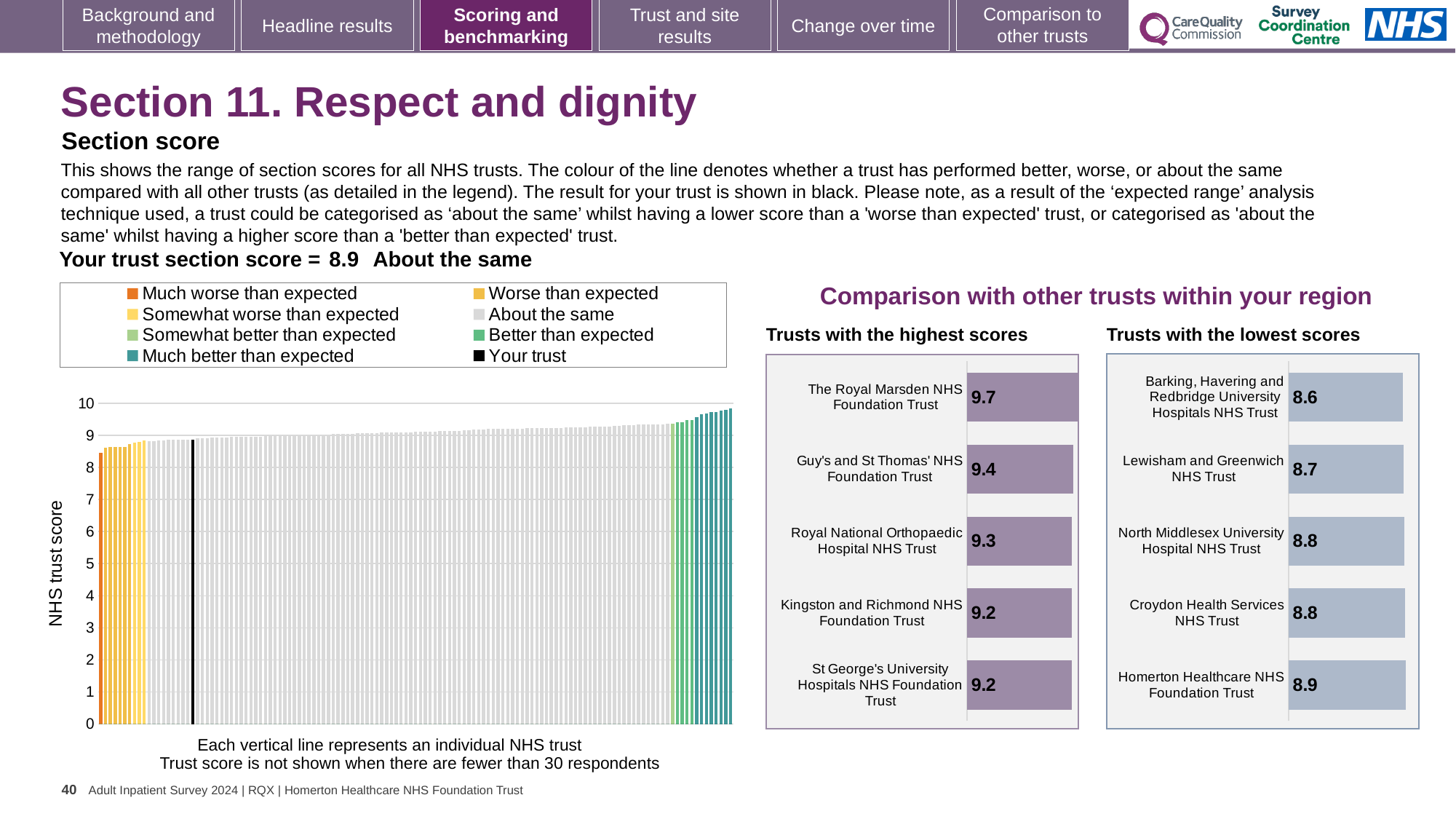
What kind of chart is the large 'NHS trust score' chart on the left of the slide? bar chart In the large 'NHS trust score' chart on the left, is the value for the black 'Your trust' bar greater or less than 5? greater In the 'Trusts with the highest scores' chart, which has the higher score: Royal National Orthopaedic Hospital NHS Trust or Kingston and Richmond NHS Foundation Trust? Royal National Orthopaedic Hospital NHS Trust In the 'Trusts with the highest scores' chart, which trust has the highest score? The Royal Marsden NHS Foundation Trust In the 'Trusts with the lowest scores' chart, which trust has the lowest score? Barking, Havering and Redbridge University Hospitals NHS Trust In the 'Trusts with the highest scores' chart, what is the difference between the scores of The Royal Marsden NHS Foundation Trust and Guy's and St Thomas' NHS Foundation Trust? 0.3 How many entries does the legend of the large 'NHS trust score' chart on the left list? 8 In the 'Trusts with the lowest scores' chart, what is the score for Lewisham and Greenwich NHS Trust? 8.7 In the 'Trusts with the lowest scores' chart, what is the difference between the scores of Homerton Healthcare NHS Foundation Trust and Barking, Havering and Redbridge University Hospitals NHS Trust? 0.3 In the 'Trusts with the highest scores' chart, what is the score for The Royal Marsden NHS Foundation Trust? 9.7 In the 'Trusts with the lowest scores' chart, what is the score for Homerton Healthcare NHS Foundation Trust? 8.9 How many trusts are shown in the 'Trusts with the highest scores' chart? 5